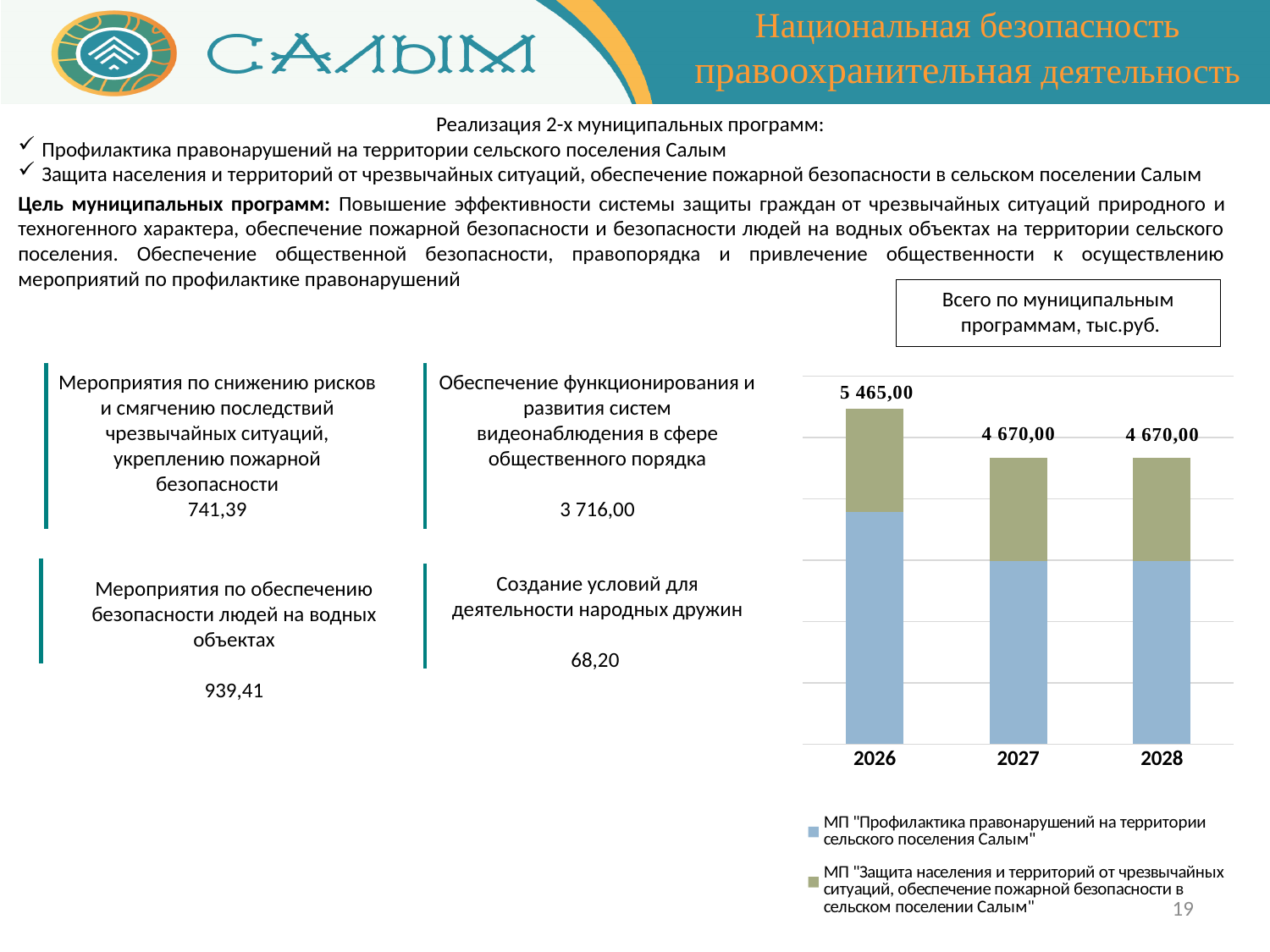
What is the total value shown for 2026 in the chart? 5 465,00 Which series is shown in the lower (blue) segment of each bar according to the legend? МП "Профилактика правонарушений на территории сельского поселения Салым" How many series does the chart legend list? 2 What is the total value shown for 2028 in the chart? 4 670,00 What is the total value shown for 2027 in the chart? 4 670,00 Which year has the highest total in the chart? 2026 What is the title of the chart? Всего по муниципальным программам, тыс.руб. Which total is larger, 2026 or 2028? 2026 Do the totals rise or fall from 2026 to 2027? Fall How many years (categories) are shown on the x axis of the chart? 3 What kind of chart is shown on the slide? Stacked bar chart What is the difference between the totals for 2026 and 2027? 795,00